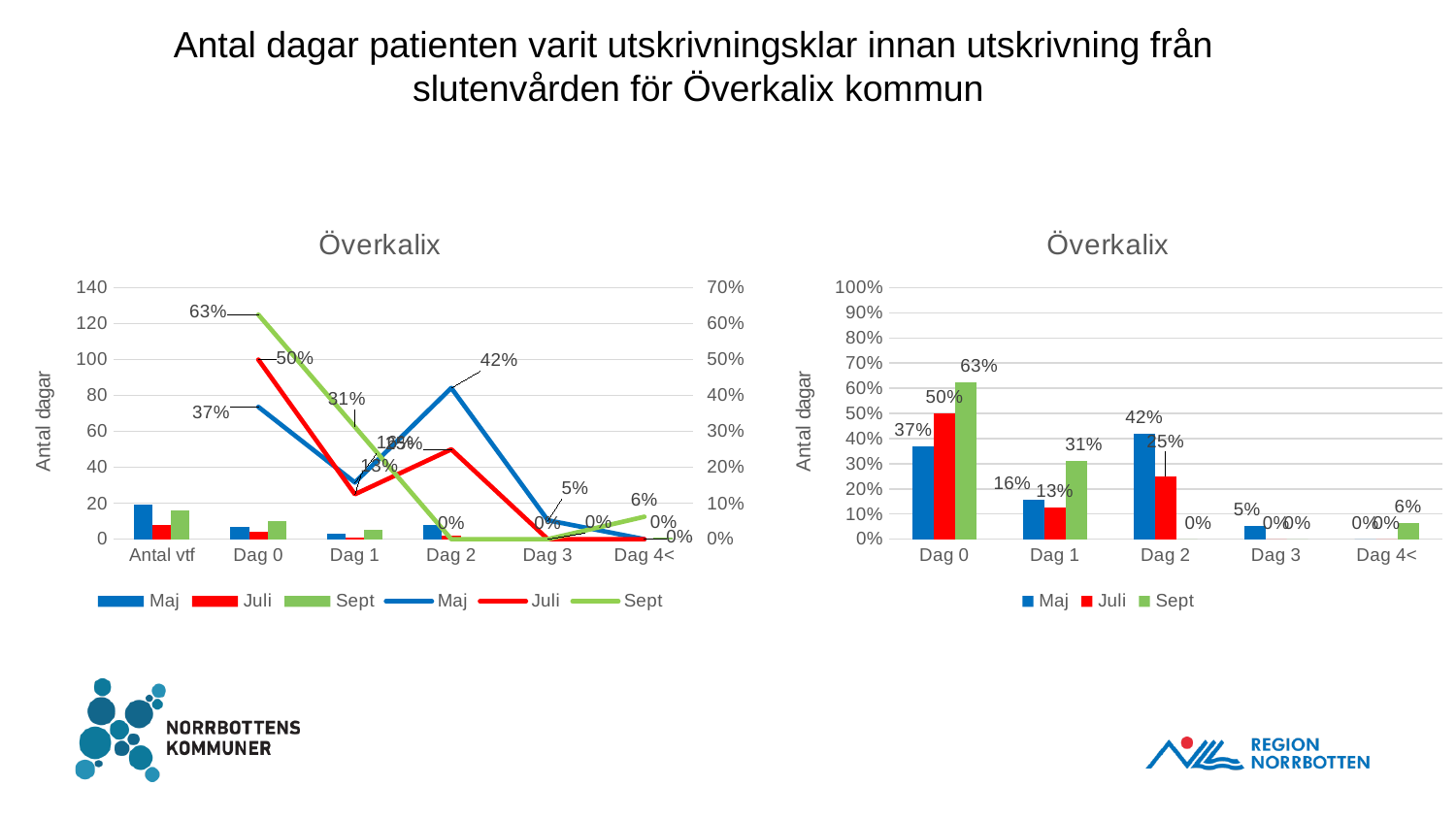
In the right chart, what is the difference between the Sept and Maj values at Dag 0? 26% In the right chart, which is larger at Dag 2: Maj or Juli? Maj What kind of chart is the right chart? Bar chart In the left chart, does the Sept line rise or fall from Dag 0 to Dag 2? fall In the right chart, which series has the highest value at Dag 1? Sept How many categories are shown on the x axis of the left chart? 6 How many series does the legend of the right chart list? 3 In the right chart, what is the value for Maj at Dag 2? 42% In the left chart, what is the value of the Sept line at Dag 1? 31% How many categories are shown on the x axis of the right chart? 5 In the right chart, what is the value for Sept at Dag 0? 63% In the left chart, is the Maj bar for Antal vtf greater or less than 10? greater